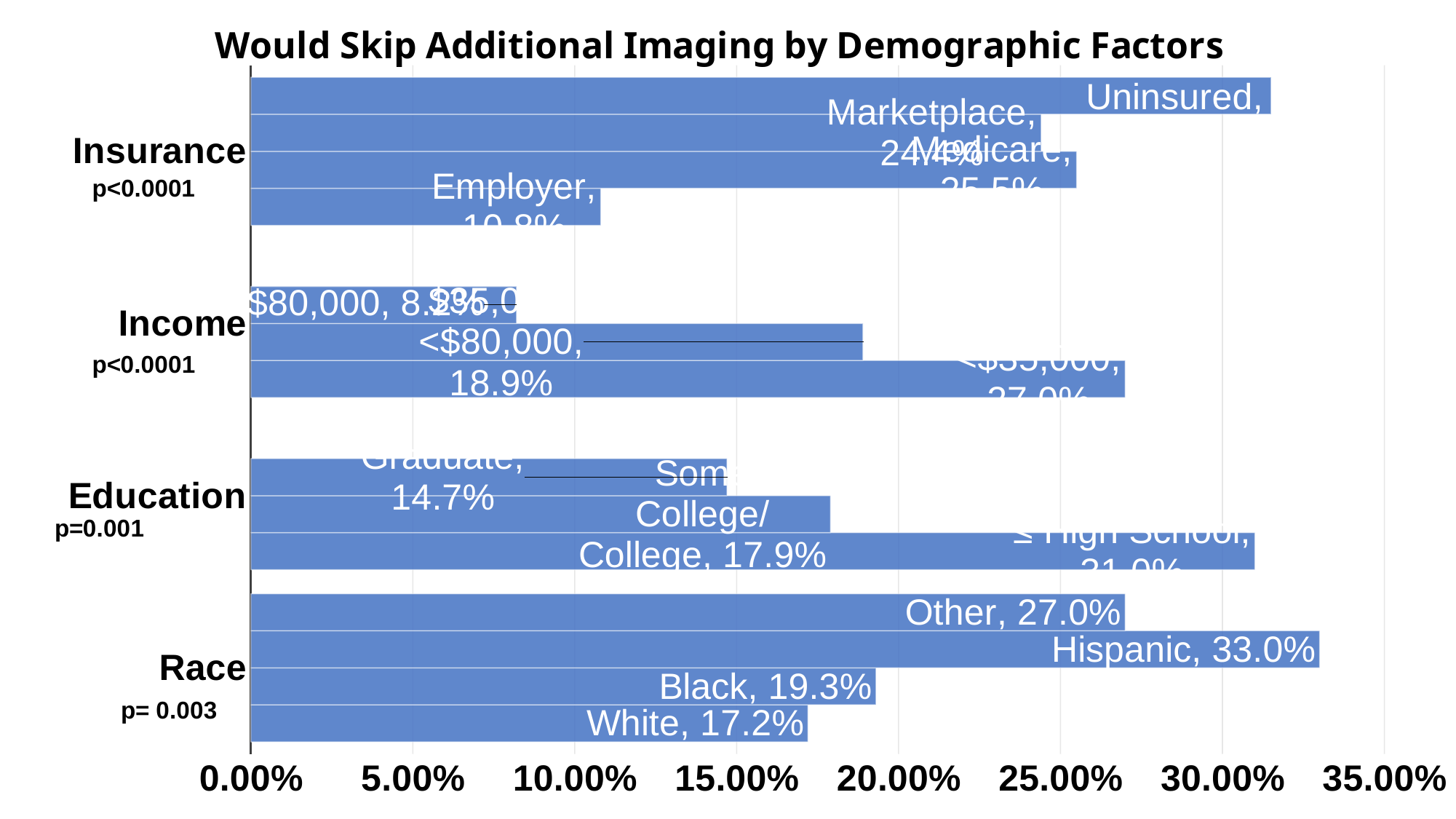
Which category in the Race group has the highest value? Hispanic What is the difference between the Hispanic and White values? 15.8% What is the title of the chart? Would Skip Additional Imaging by Demographic Factors What percentage of Hispanic respondents would skip additional imaging? 33.0% Which is larger, the value for Black or the value for White? Black What is the value for White in the Race group? 17.2% What is the value for Graduate in the Education group? 14.7% What is the value for <$80,000 in the Income group? 18.9% Which category in the Race group has the lowest value? White How many demographic factor groups are shown on the chart? 4 What kind of chart is shown on the slide? bar chart Is the value for Uninsured greater or less than 30.00%? greater